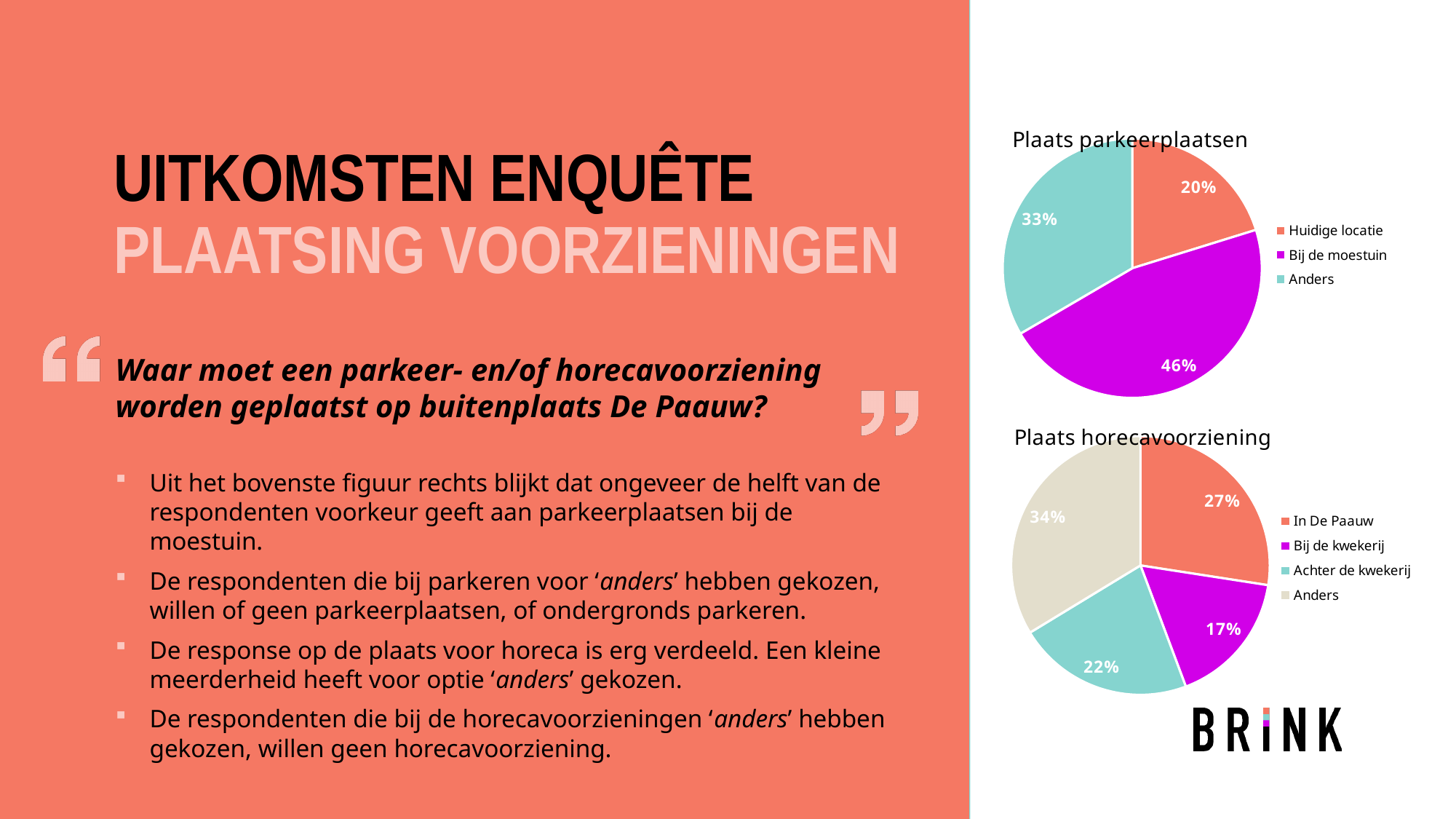
In the 'Plaats parkeerplaatsen' chart, which category has the largest share? Bij de moestuin In the 'Plaats horecavoorziening' chart, which category has the smallest share? Bij de kwekerij In the 'Plaats parkeerplaatsen' chart, what share of respondents chose 'Huidige locatie'? 20% In the 'Plaats parkeerplaatsen' chart, what share of respondents chose 'Bij de moestuin'? 46% In the 'Plaats horecavoorziening' chart, what colour is the 'Anders' slice? Beige In the 'Plaats parkeerplaatsen' chart, what is the difference in percentage points between 'Bij de moestuin' and 'Anders'? 13 In the 'Plaats horecavoorziening' chart, which is larger: 'In De Paauw' or 'Achter de kwekerij'? In De Paauw In the 'Plaats horecavoorziening' chart, what share of respondents chose 'Anders'? 34% In the 'Plaats parkeerplaatsen' chart, which category has the smallest share? Huidige locatie In the 'Plaats horecavoorziening' chart, what share of respondents chose 'Achter de kwekerij'? 22% How many categories does the 'Plaats horecavoorziening' chart show? 4 What type of chart is 'Plaats parkeerplaatsen'? Pie chart